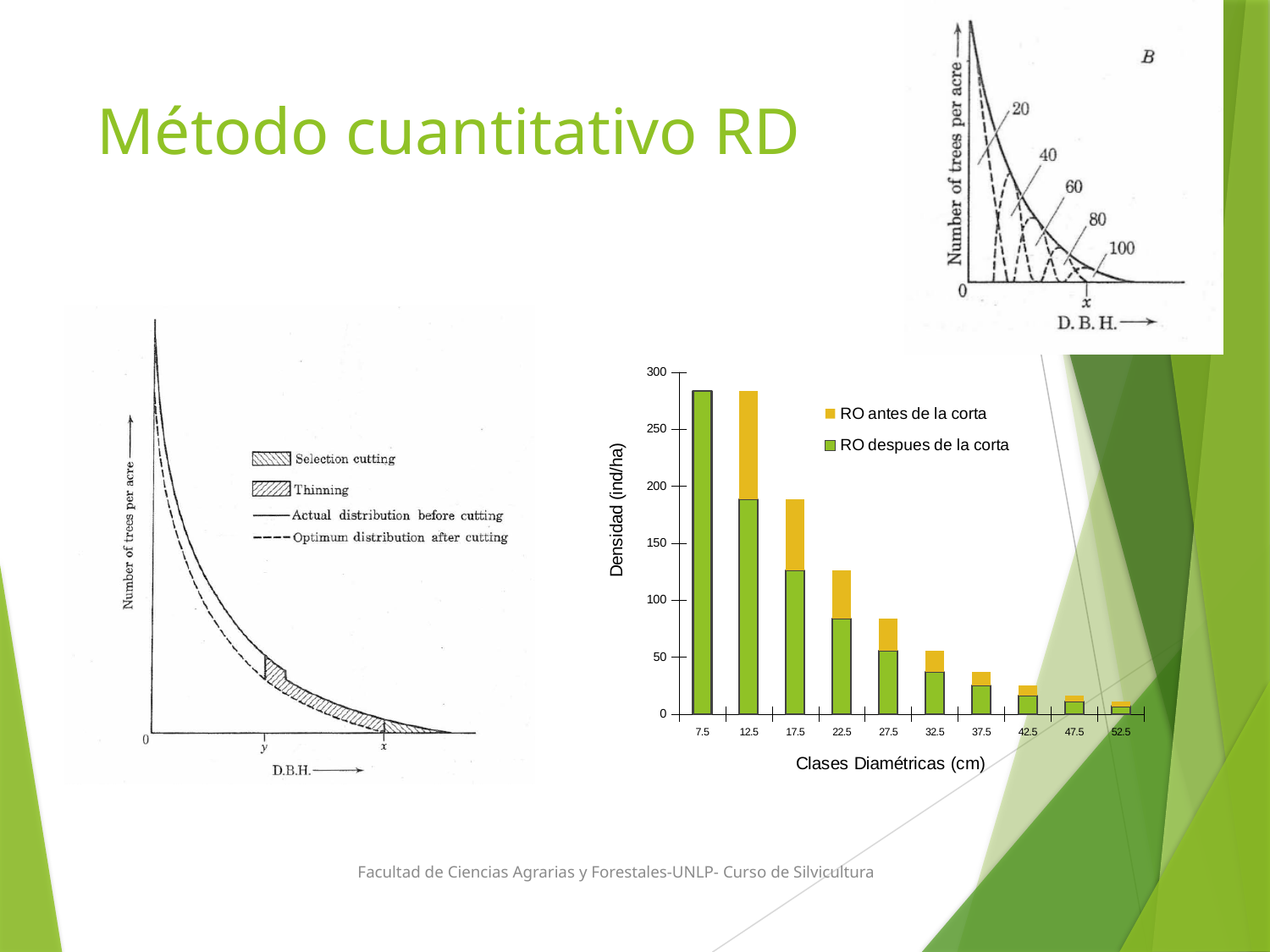
What is the title of the vertical axis of the bar chart at the lower right? Densidad (ind/ha) In the bar chart at the lower right, which diameter class has the highest value for 'RO despues de la corta'? 7.5 In the bar chart at the lower right, which diameter class has the lowest value for 'RO antes de la corta'? 52.5 In the bar chart at the lower right, is the value for 'RO despues de la corta' at class 32.5 greater or less than 50? less In the bar chart at the lower right, is the value for 'RO despues de la corta' at class 12.5 greater or less than 200? less What kind of chart is the one at the lower right with the axis 'Clases Diamétricas (cm)'? bar chart In the bar chart at the lower right, do the values for 'RO antes de la corta' rise or fall as the diameter class increases? fall In the bar chart at the lower right, how many diameter classes are shown on the x axis? 10 In the bar chart at the lower right (Densidad vs Clases Diamétricas), how many series does the legend list? 2